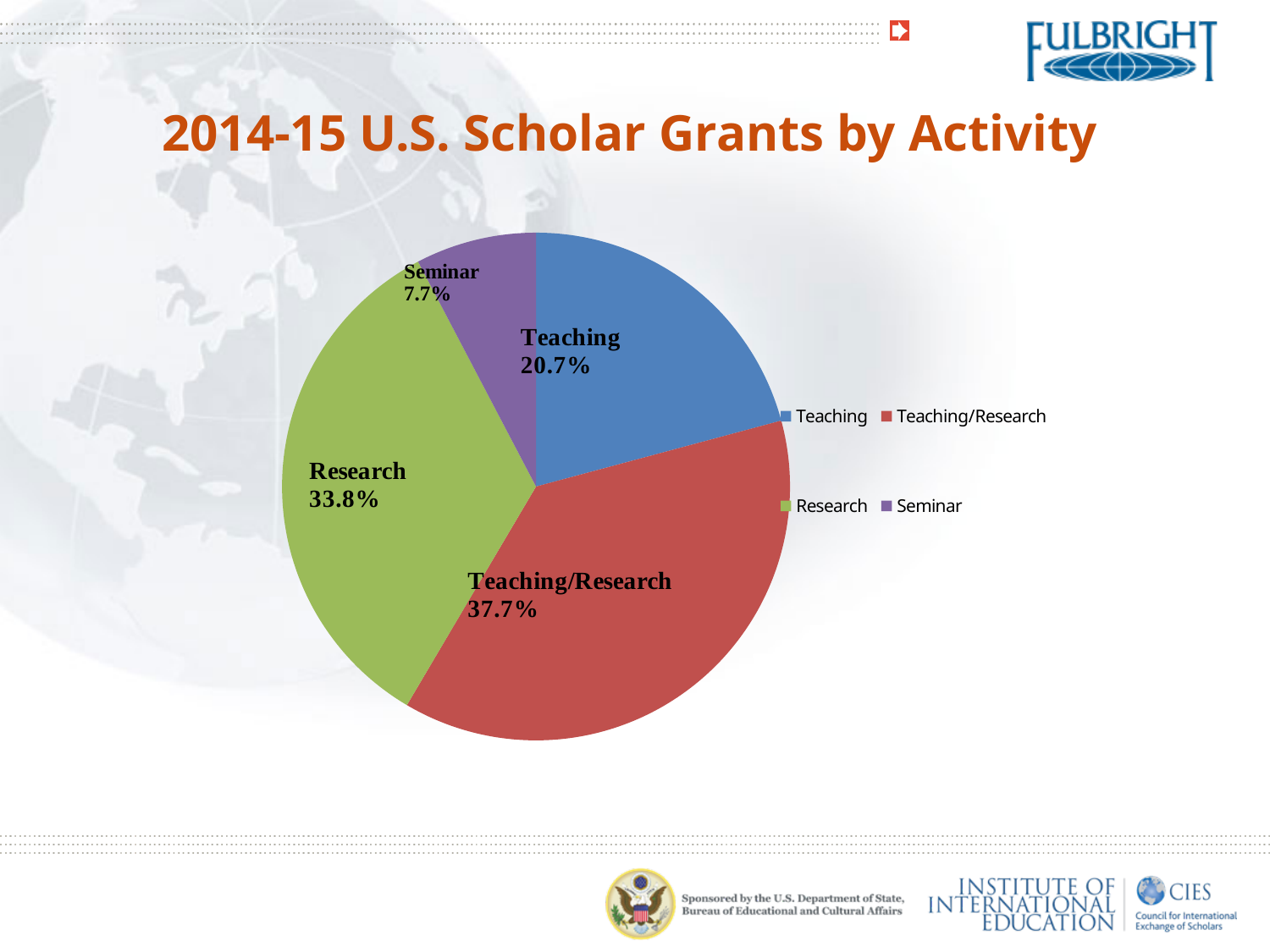
What share of 2014-15 U.S. Scholar Grants went to Teaching/Research? 37.7% Which activity has the smallest share of grants? Seminar Which has a larger share, Teaching or Research? Research What percentage of grants is shown for Seminar? 7.7% What is the title of the chart? 2014-15 U.S. Scholar Grants by Activity What kind of chart is shown on the slide? Pie chart What percentage of grants is shown for Teaching? 20.7% How many activity categories does the pie chart show? 4 Which activity has the largest share of grants? Teaching/Research What is the difference in percentage points between Teaching and Seminar? 13.0 What percentage of grants is shown for Research? 33.8% What is the difference in percentage points between Teaching/Research and Research? 3.9